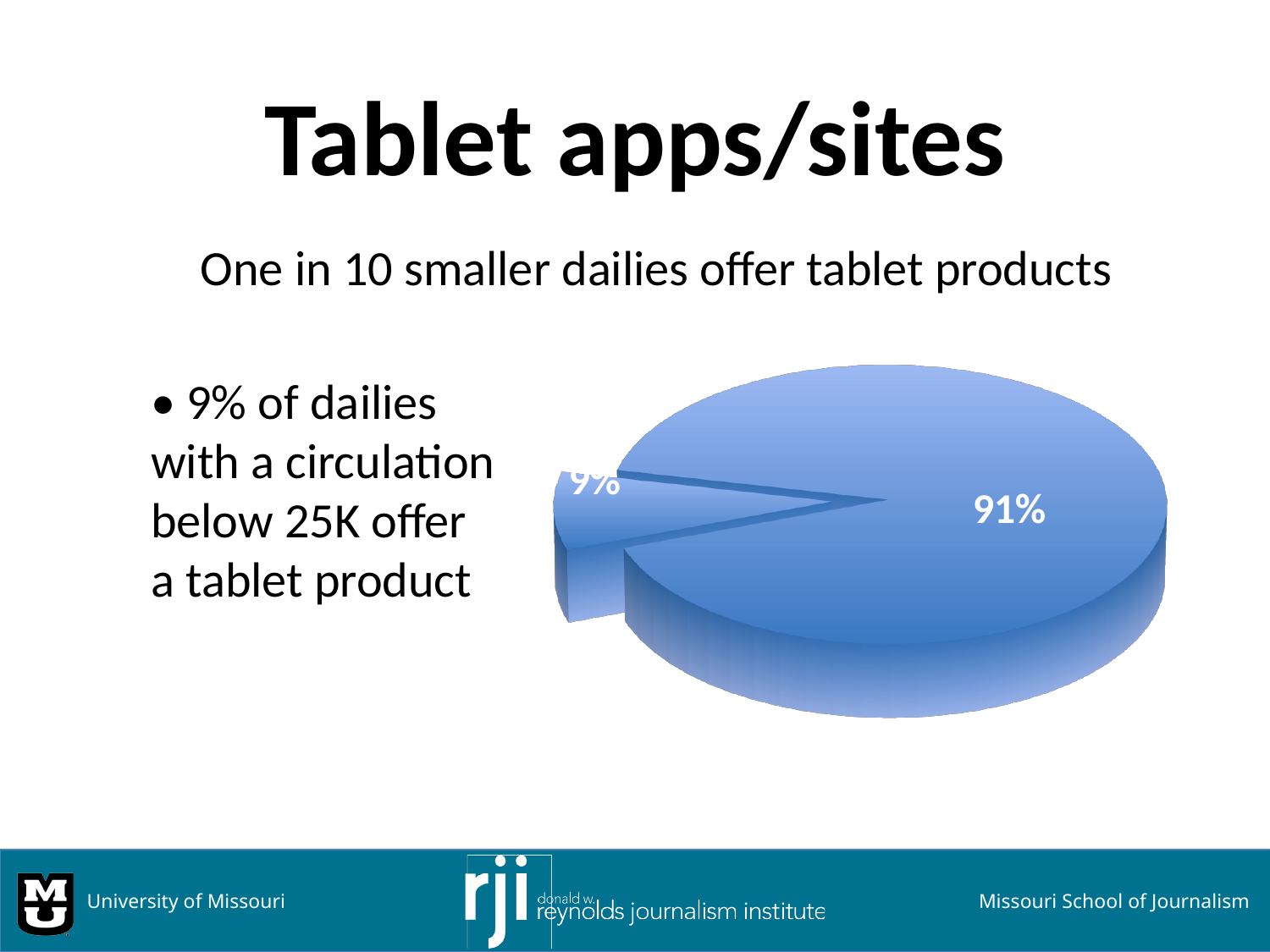
What colour are the slices of the pie chart? blue According to the slide, what percentage of dailies with a circulation below 25K offer a tablet product? 9% What do the two slices of the pie chart add up to? 100% What is the value of the smallest slice of the pie chart? 9% What share of the pie does the exploded (separated) slice represent? 9% What is the value of the largest slice of the pie chart? 91% What is the title of the slide containing the pie chart? Tablet apps/sites What kind of chart is shown on the slide? pie chart Which slice is larger, the 91% slice or the 9% slice? 91% How many slices does the pie chart have? 2 What is the difference in percentage points between the two slices of the pie chart? 82